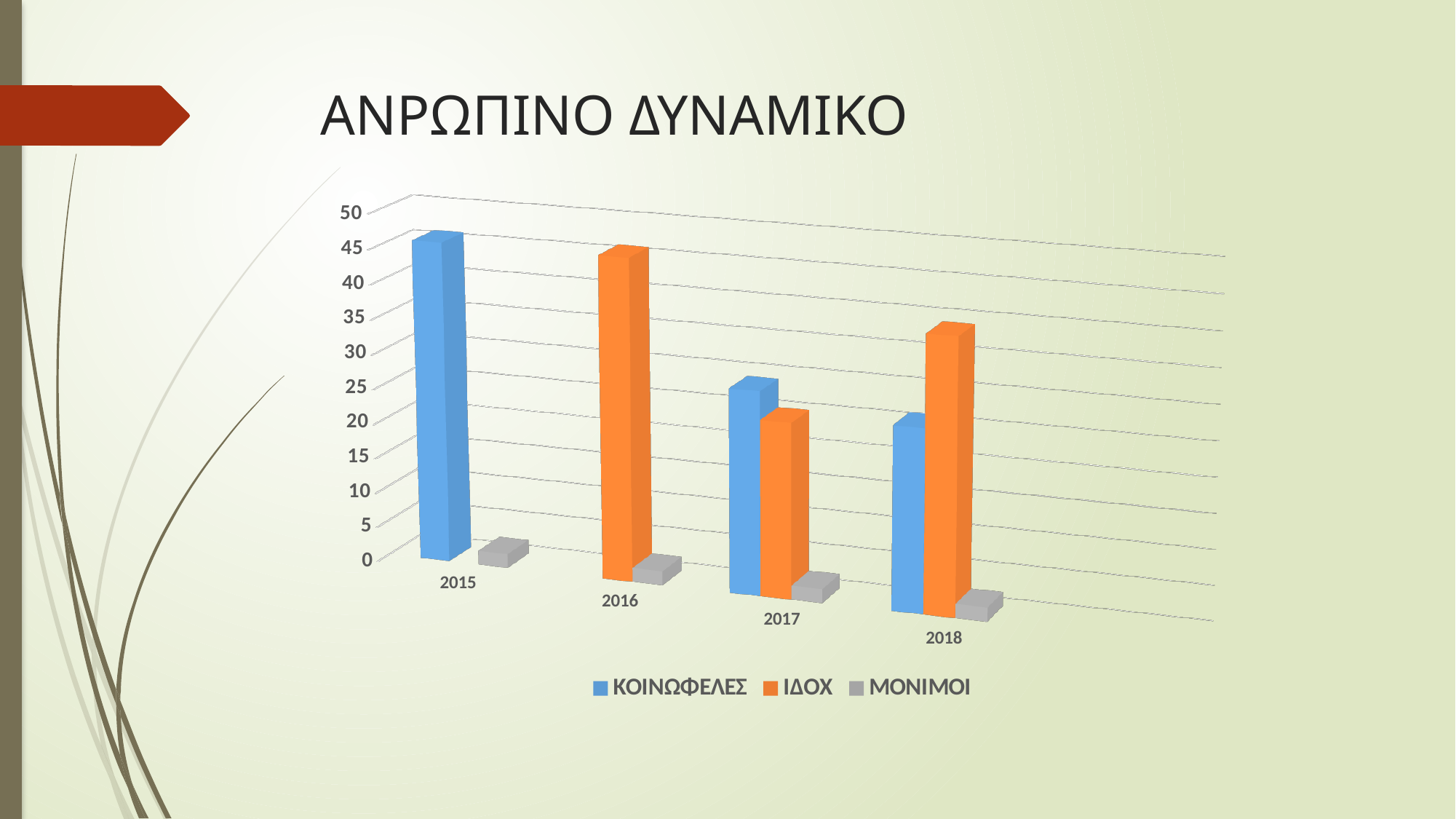
In which year is the ΚΟΙΝΩΦΕΛΕΣ bar highest? 2015 Which series is shown in orange? ΙΔΟΧ Is the value for ΜΟΝΙΜΟΙ in 2017 greater or less than 5? less What is the title of the chart? ΑΝΡΩΠΙΝΟ ΔΥΝΑΜΙΚΟ Is the value for ΚΟΙΝΩΦΕΛΕΣ in 2015 greater or less than 40? greater Is the value for ΙΔΟΧ in 2018 greater or less than 30? greater What kind of chart is shown on the slide? bar chart In which year is the ΙΔΟΧ bar highest? 2016 How many years are shown on the x axis? 4 In 2018, which is larger, ΚΟΙΝΩΦΕΛΕΣ or ΙΔΟΧ? ΙΔΟΧ How many series does the legend list? 3